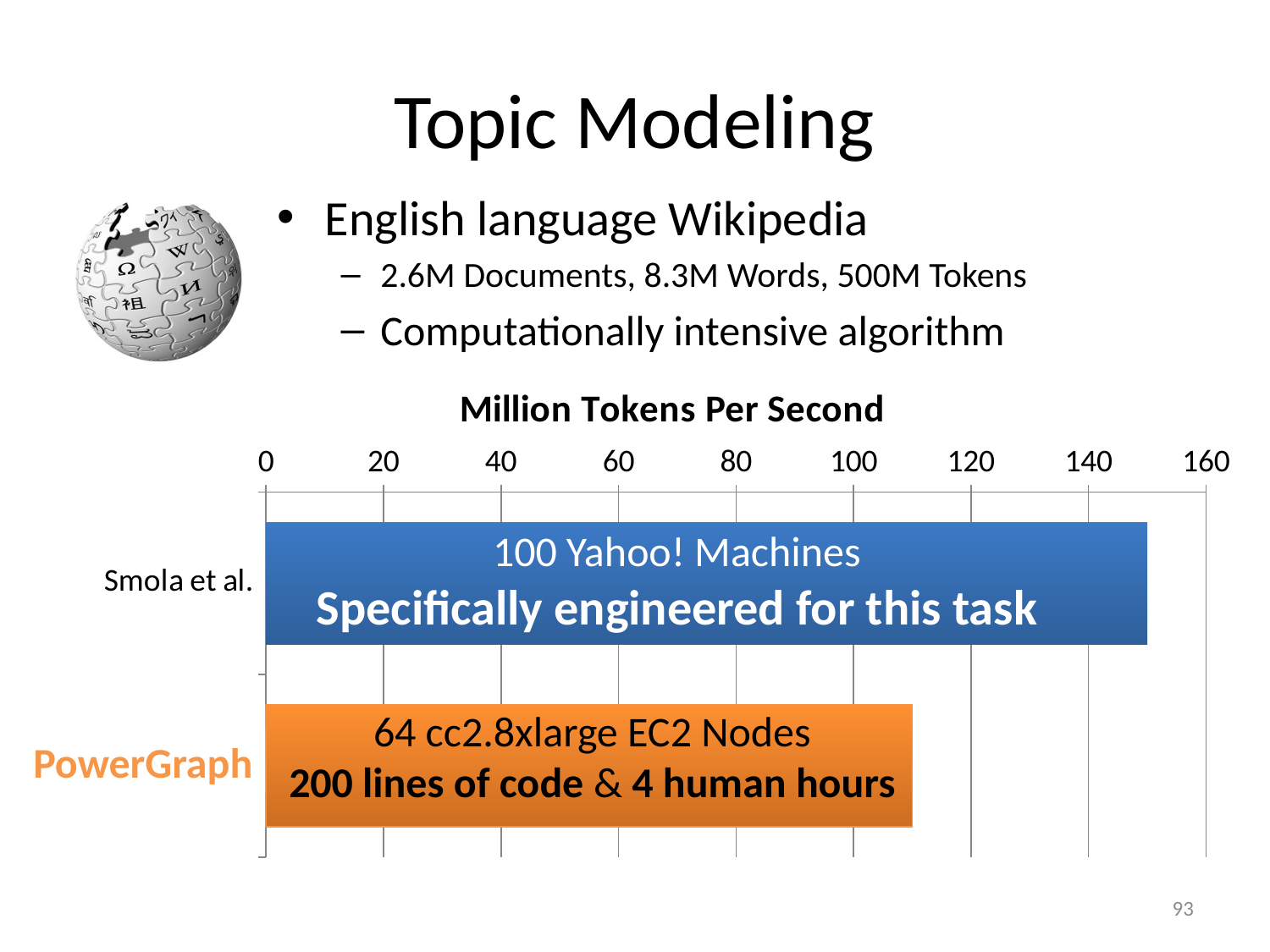
Which has a larger value, Smola et al. or PowerGraph? Smola et al. What is the maximum value shown on the chart's horizontal axis? 160 How many categories (bars) does the chart show? 2 What kind of chart is shown on the slide? bar chart Is the value for Smola et al. greater or less than 160? less Is the value for PowerGraph greater or less than 100? greater Is the value for Smola et al. greater or less than 140? greater What colour is the PowerGraph bar? orange Which category has the highest value in the Million Tokens Per Second chart? Smola et al. Which category has the lowest value in the Million Tokens Per Second chart? PowerGraph What is the title of the chart? Million Tokens Per Second